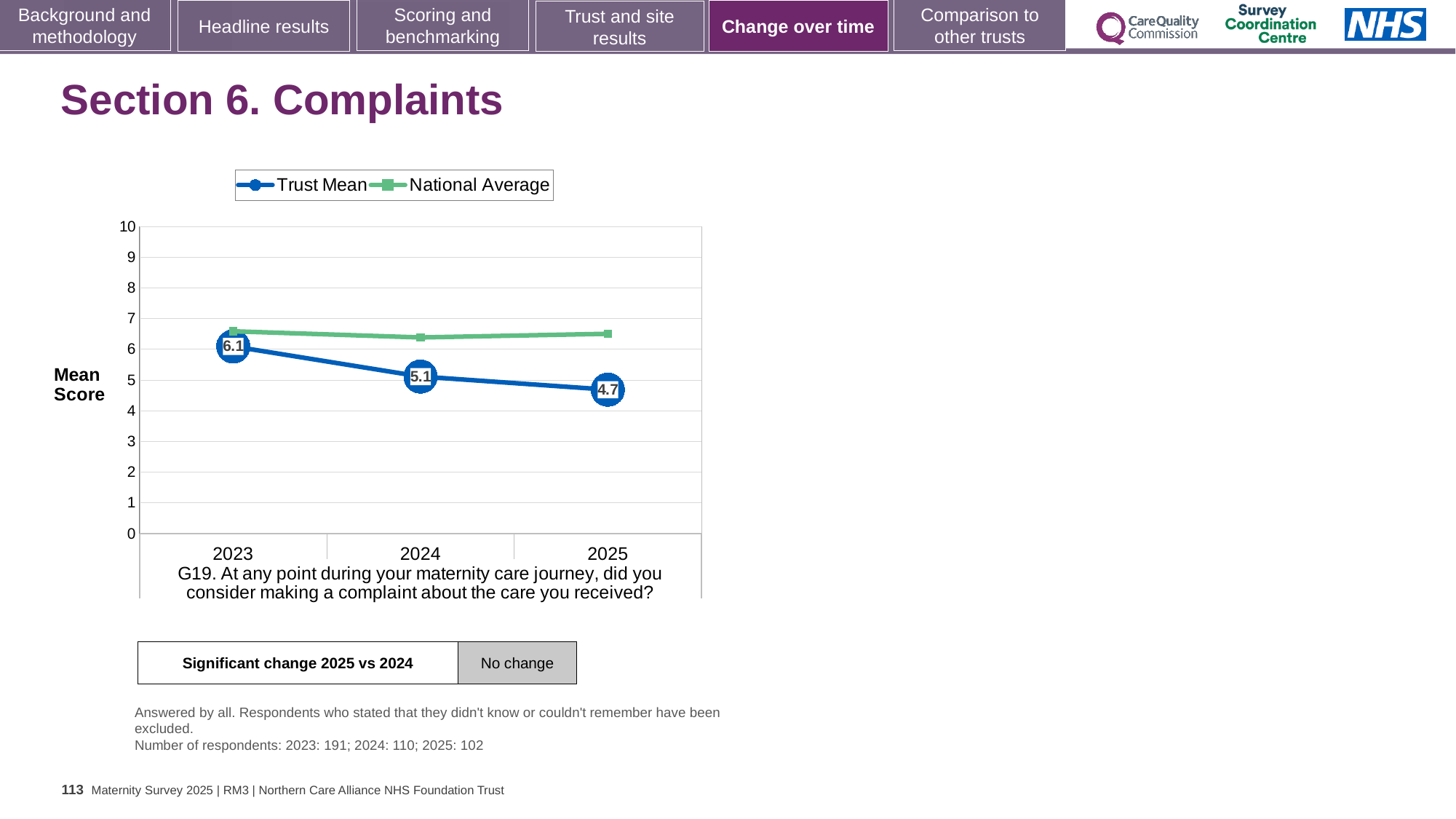
What is the Trust Mean score for 2025? 4.7 In which year is the Trust Mean score highest? 2023 Is the National Average for 2024 greater or less than 6? greater What is the Trust Mean score for 2023? 6.1 How many years are shown on the x axis? 3 What kind of chart is shown? line chart Which is larger in 2025, the Trust Mean or the National Average? National Average Does the Trust Mean rise or fall from 2023 to 2025? fall How many series does the legend list? 2 In which year is the Trust Mean score lowest? 2025 What is the Trust Mean score for 2024? 5.1 What is the difference between the Trust Mean scores for 2023 and 2025? 1.4